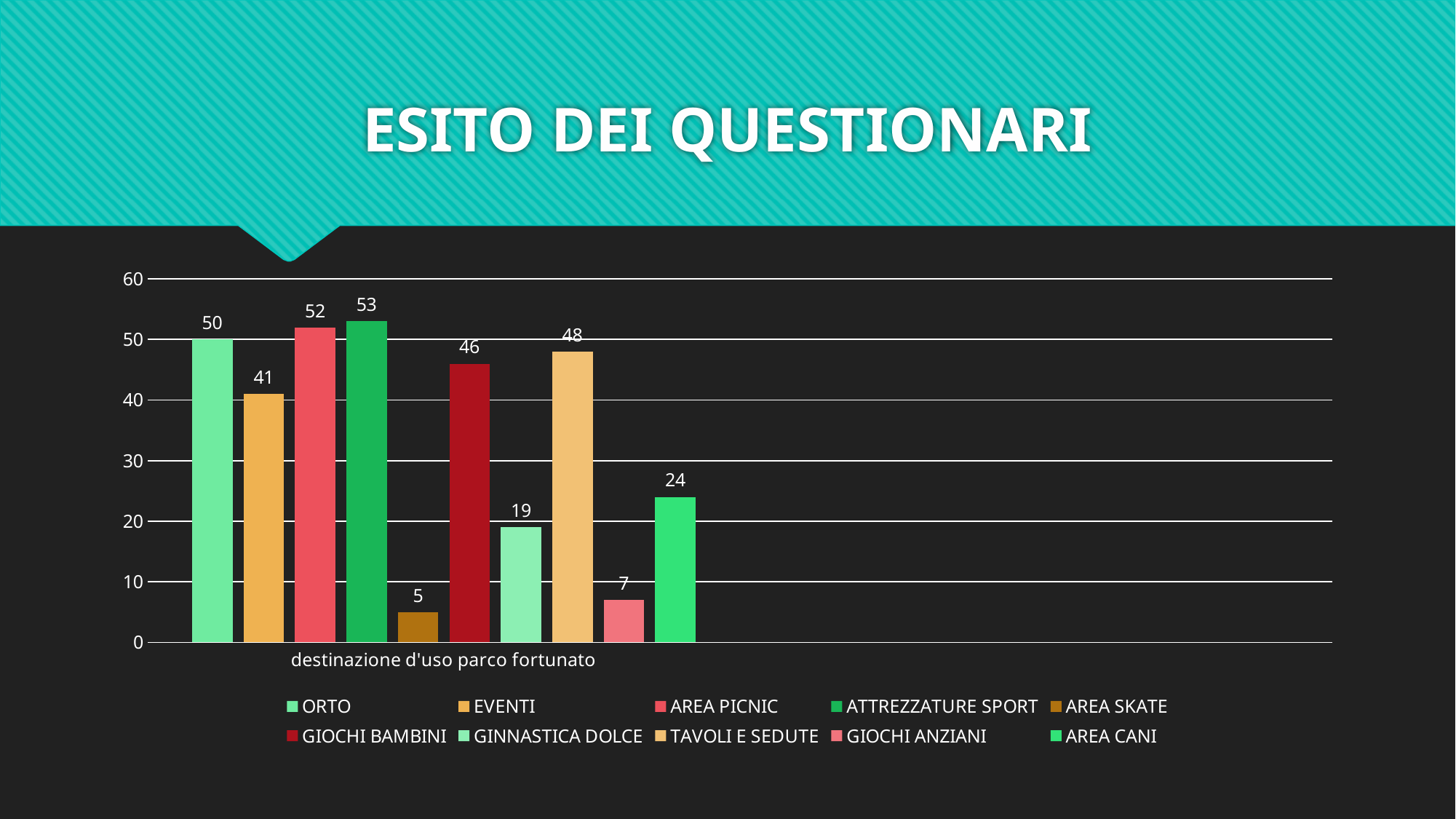
What is the value for AREA CANI? 24 Which is larger, the value for GIOCHI ANZIANI or the value for AREA SKATE? GIOCHI ANZIANI Which series has the lowest value? AREA SKATE How many series does the legend list? 10 What is the title of the slide? ESITO DEI QUESTIONARI What is the difference between the values for AREA PICNIC and EVENTI? 11 What kind of chart is shown on the slide? bar chart What is the value for GIOCHI BAMBINI? 46 Which series has the highest value? ATTREZZATURE SPORT What is the value for ORTO? 50 What is the difference between the values for TAVOLI E SEDUTE and GINNASTICA DOLCE? 29 Is the value for GINNASTICA DOLCE greater or less than 20? less